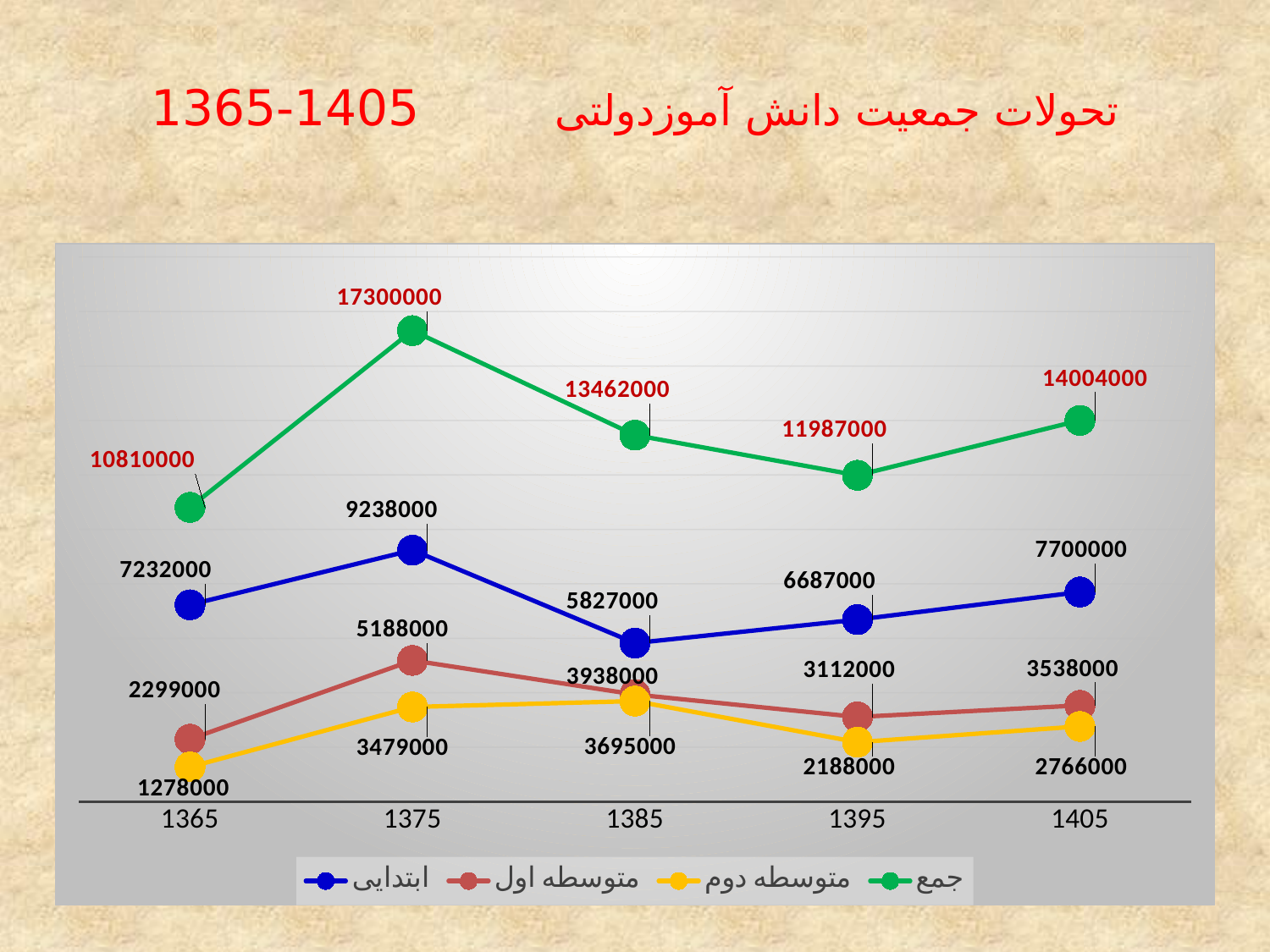
What is the value of the متوسطه اول series in 1405? 3538000 What is the value of the جمع series in 1375? 17300000 Does the جمع series rise or fall from 1375 to 1395? fall Which is larger in 1385, the متوسطه اول value or the متوسطه دوم value? متوسطه اول How many years are shown on the x axis? 5 What is the value of the ابتدایی series in 1385? 5827000 In which year is the ابتدایی series lowest? 1385 In which year is the جمع series highest? 1375 What kind of chart is shown on the slide? line chart What is the value of the متوسطه دوم series in 1365? 1278000 What is the difference between the جمع values in 1375 and 1365? 6490000 How many series does the legend list? 4